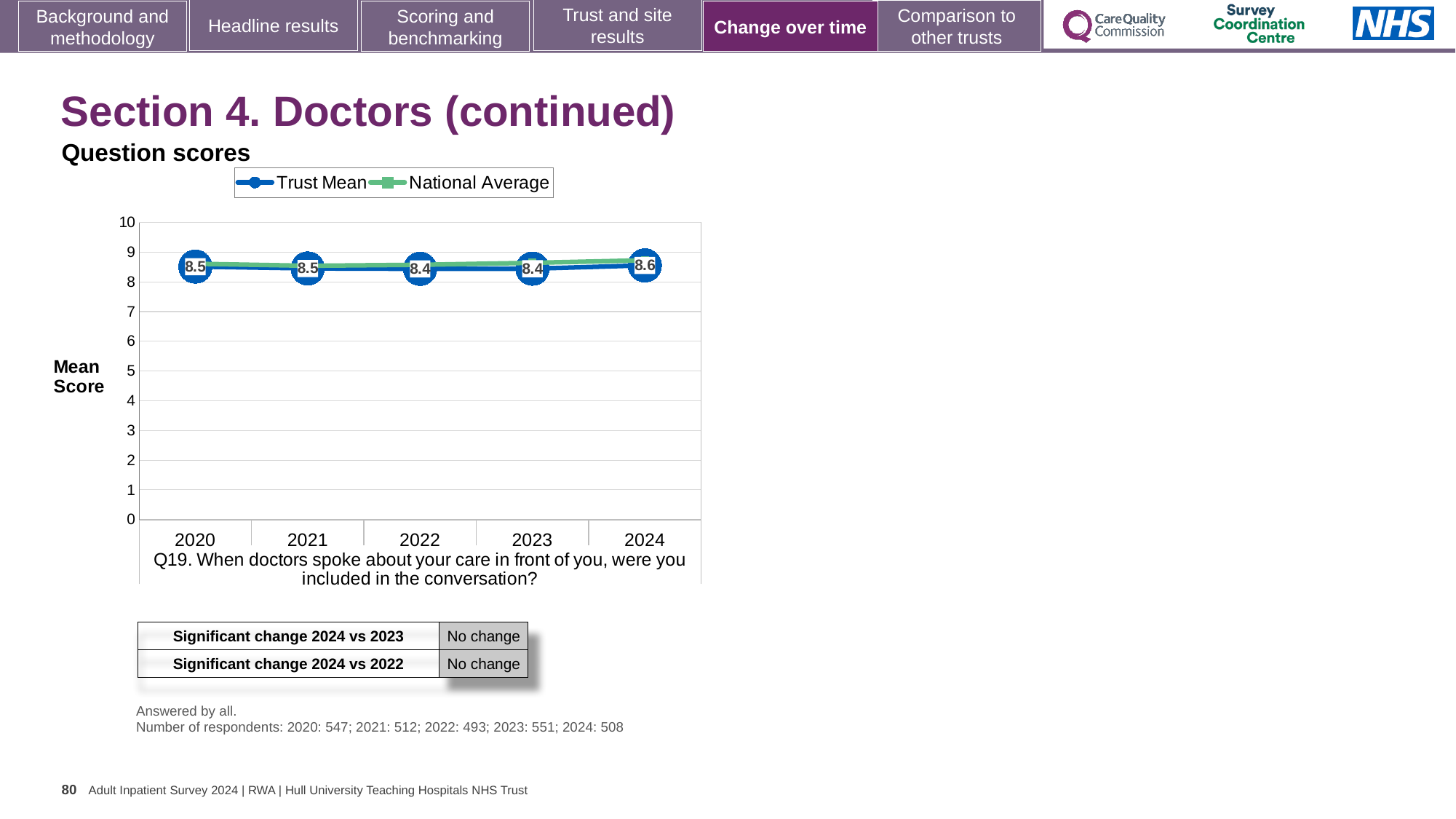
Does the Trust Mean score rise or fall from 2023 to 2024? rise How many years are plotted on the x axis? 5 Is the Trust Mean score for 2021 greater or less than 8? greater What is the difference between the Trust Mean scores for 2024 and 2023? 0.2 In which year is the Trust Mean score highest? 2024 What is the Trust Mean score for 2022? 8.4 What is the Trust Mean score for 2020? 8.5 What are the two series named in the legend? Trust Mean and National Average What kind of chart is shown? line chart How many series does the legend list? 2 What is the Trust Mean score for 2024? 8.6 Which is larger, the Trust Mean score for 2020 or for 2024? 2024